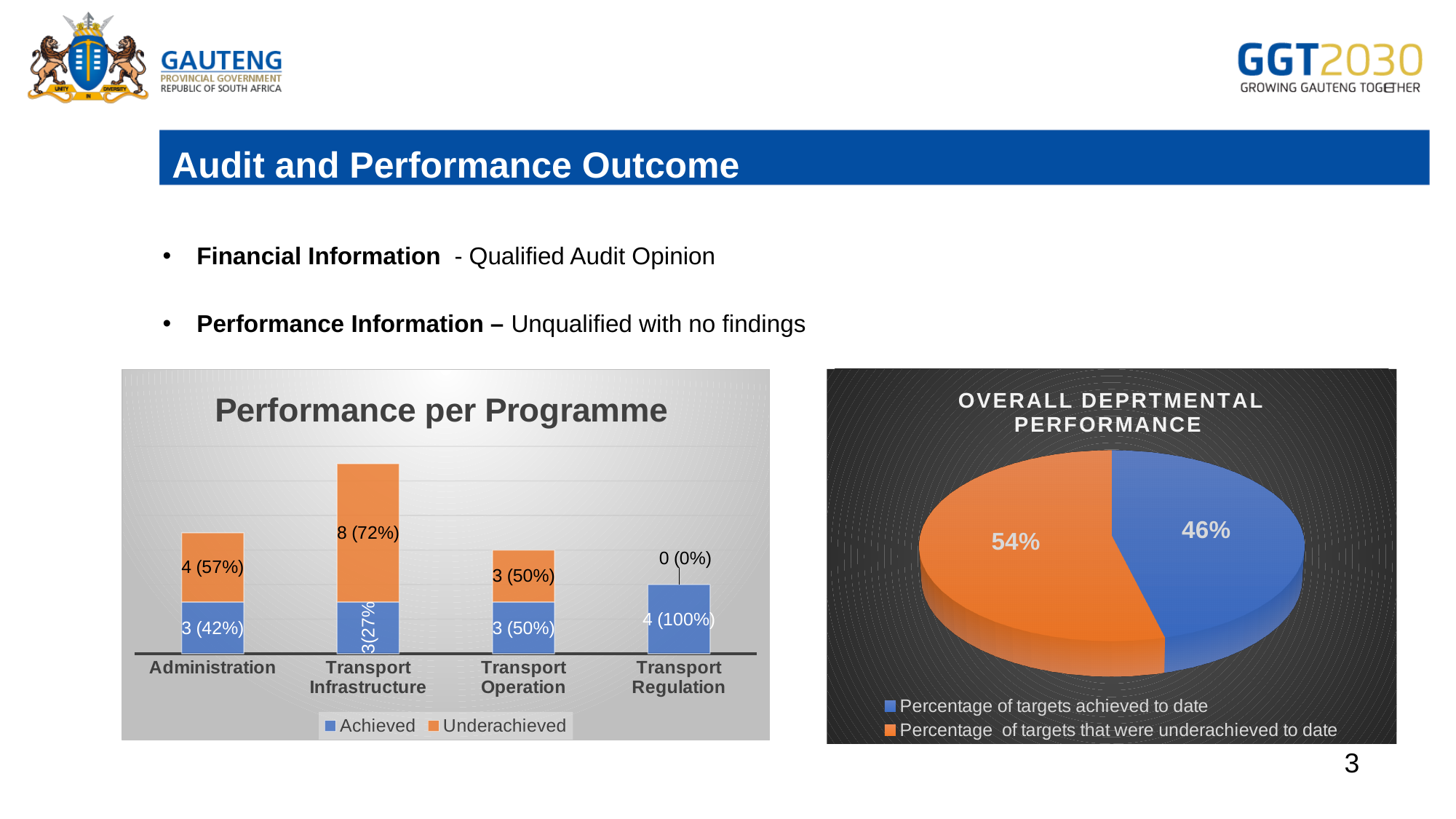
In the Overall Deprtmental Performance pie chart, what share of targets were achieved to date? 46% What kind of chart is the Performance per Programme chart? Stacked bar chart In the Performance per Programme chart, what is the Underachieved value for Transport Infrastructure? 8 (72%) In the Overall Deprtmental Performance pie chart, which slice is larger: targets achieved or targets underachieved? Targets underachieved In the Performance per Programme chart, which programme has the highest Underachieved count? Transport Infrastructure In the Performance per Programme chart, how many series does the legend list? 2 In the Performance per Programme chart, what is the Achieved value for Administration? 3 (42%) In the Performance per Programme chart, how many more targets were underachieved than achieved for Transport Infrastructure? 5 In the Performance per Programme chart, what is the total number of targets (Achieved plus Underachieved) for Transport Infrastructure? 11 In the Performance per Programme chart, what is the Underachieved value for Transport Regulation? 0 (0%) In the Performance per Programme chart, how many programmes are shown on the x axis? 4 In the Performance per Programme chart, which programme has the lowest Underachieved count? Transport Regulation